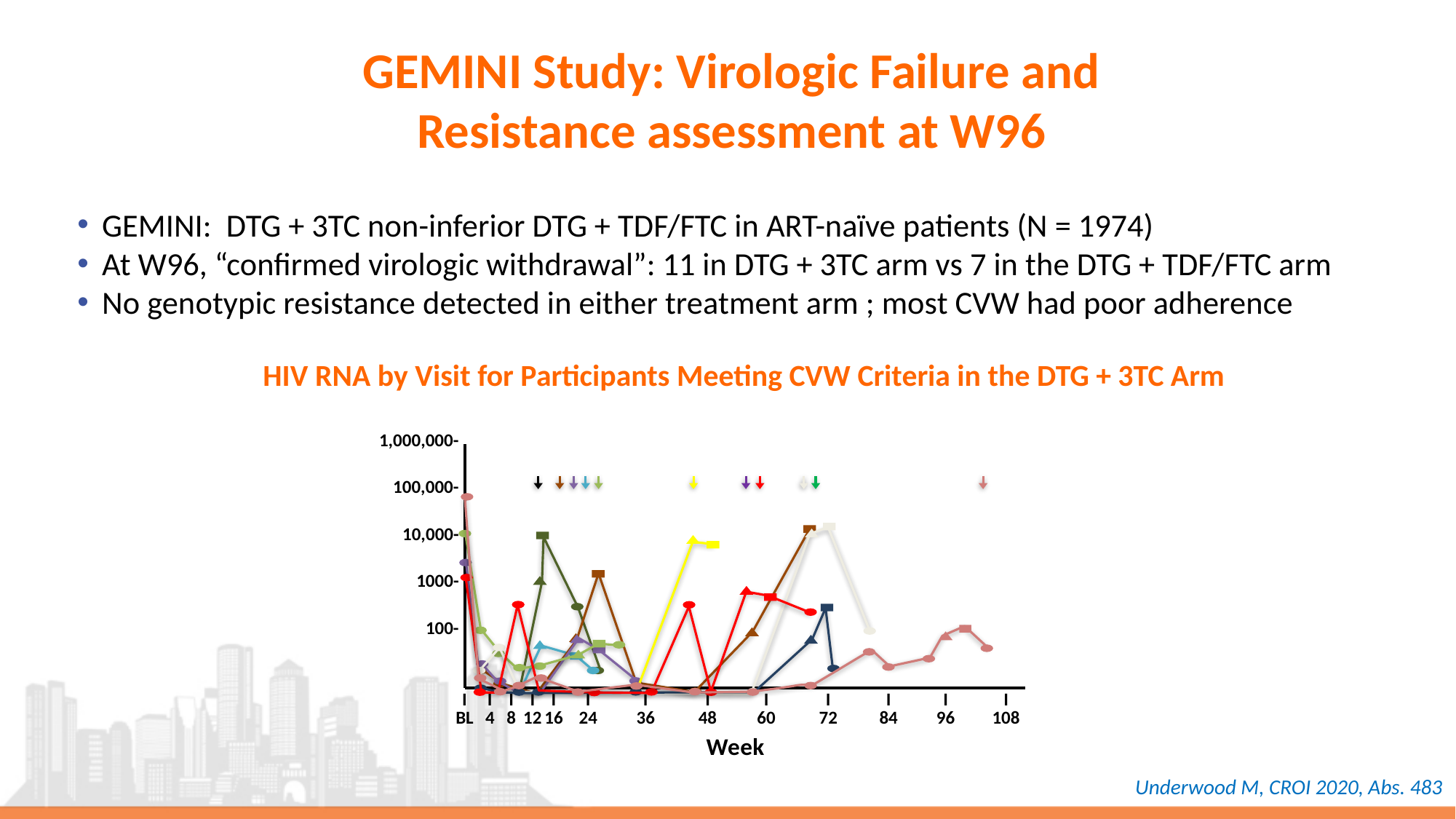
What is the first tick label on the x axis of the chart? BL Is the peak value of the brown line (around week 68) greater or less than 1000? greater Is the peak value of the yellow line (around week 44-48) greater or less than 100,000? less Is the value of the pink line at week 108 greater or less than 100? less How many tick labels are shown along the x axis of the chart? 13 What is the highest value labelled on the y axis of the chart? 1,000,000 What is the label of the x axis of the chart? Week What is the title of the chart on the slide? HIV RNA by Visit for Participants Meeting CVW Criteria in the DTG + 3TC Arm What kind of chart is shown on the slide? line chart